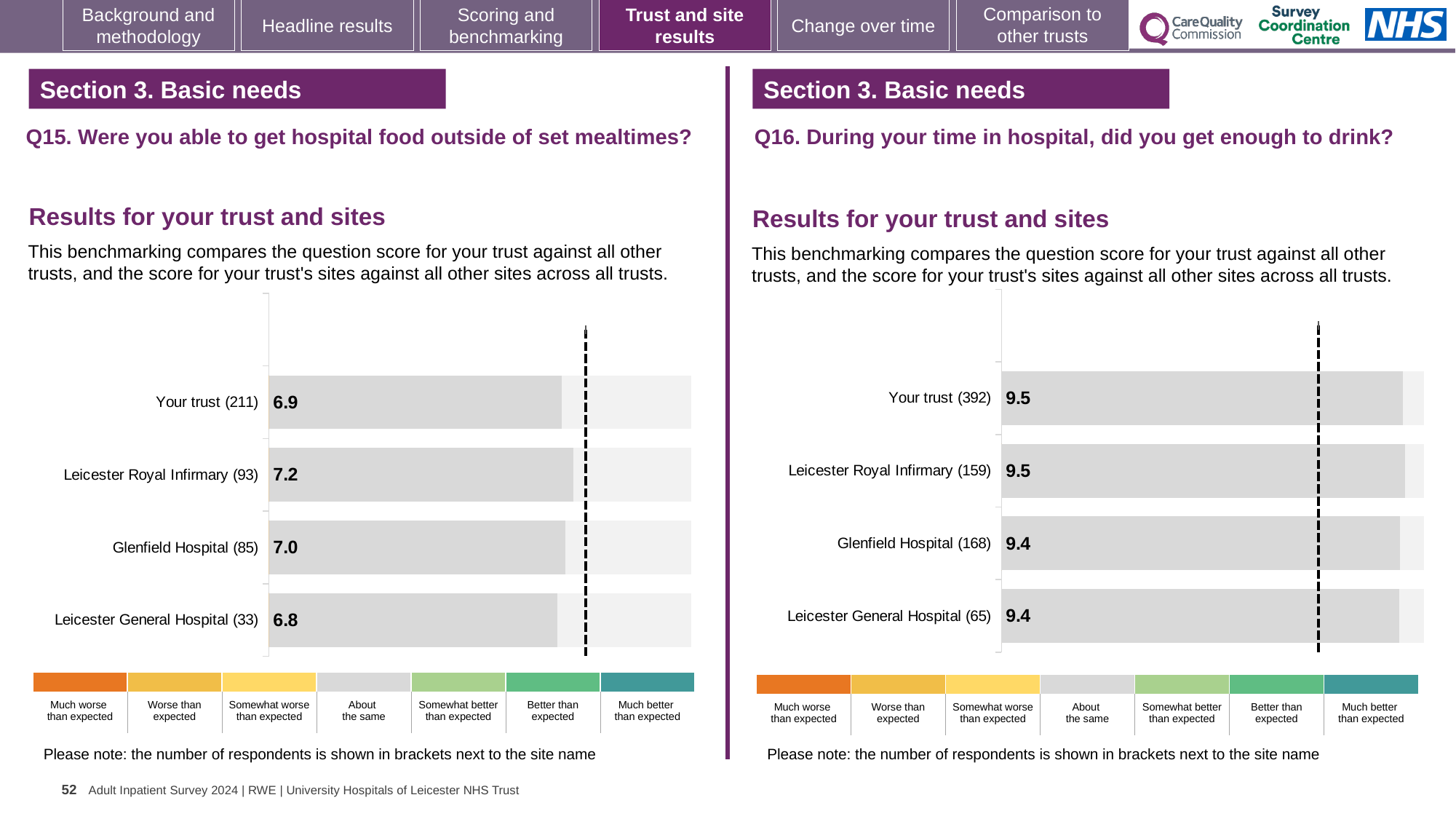
On the Q15 chart (left), which site or trust has the lowest score? Leicester General Hospital (33) On the Q15 chart (left), what is the question text shown above the chart? Q15. Were you able to get hospital food outside of set mealtimes? On the Q16 chart (right), which is larger: the score for Leicester Royal Infirmary (159) or Leicester General Hospital (65)? Leicester Royal Infirmary (159) What kind of chart is the Q16 chart (right)? Bar chart On the Q15 chart (left), what is the difference between the scores for Leicester Royal Infirmary (93) and Leicester General Hospital (33)? 0.4 On the Q15 chart (left), how many bars are plotted? 4 On the Q15 chart (left), which site or trust has the highest score? Leicester Royal Infirmary (93) On the Q15 chart (left), what is the score for Your trust (211)? 6.9 On the Q15 chart (left), what is the score for Leicester Royal Infirmary (93)? 7.2 On the Q16 chart (right), what is the score for Your trust (392)? 9.5 On the Q16 chart (right), what is the difference between the scores for Your trust (392) and Leicester General Hospital (65)? 0.1 On the Q16 chart (right), what is the score for Glenfield Hospital (168)? 9.4